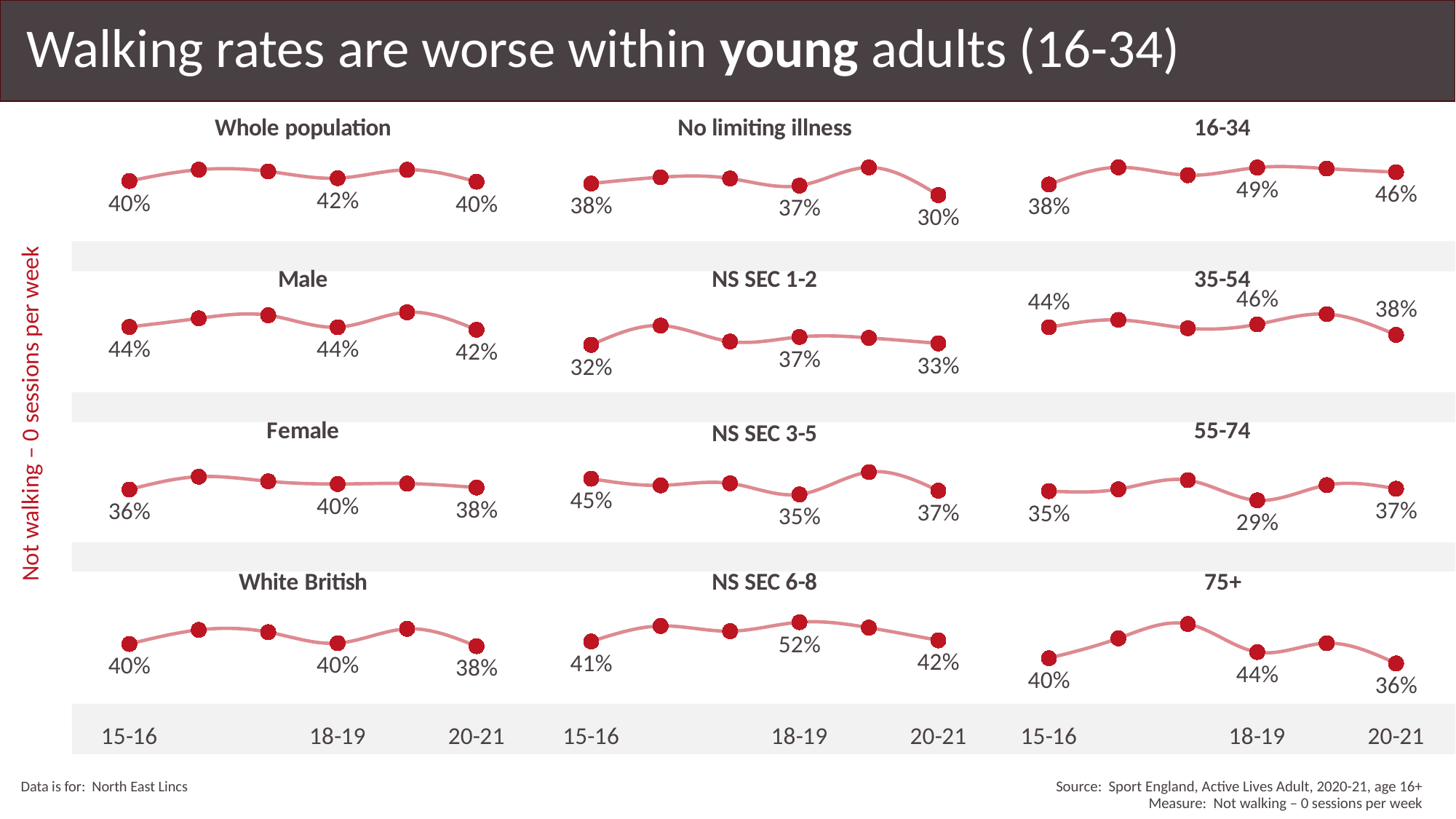
In the 'Male' chart, which is larger, the value for 15-16 or the value for 20-21? 15-16 In the '75+' chart, what is the difference between the 18-19 value and the 20-21 value? 8% In the '16-34' chart, what is the difference between the 18-19 value and the 15-16 value? 11% In the 'No limiting illness' chart, does the value rise or fall from 15-16 to 20-21? Fall In the 'No limiting illness' chart, what is the value for 20-21? 30% What kind of chart is used for the 'White British' panel? Line chart In the '55-74' chart, what is the value for 18-19? 29% How many data points are plotted in the 'Female' chart? 6 In the 'Whole population' chart, what is the value for 18-19? 42% In the '16-34' chart, what is the value for 20-21? 46% In the 'NS SEC 6-8' chart, what is the value for 18-19? 52% In the 'NS SEC 3-5' chart, which is larger, the value for 15-16 or the value for 18-19? 15-16